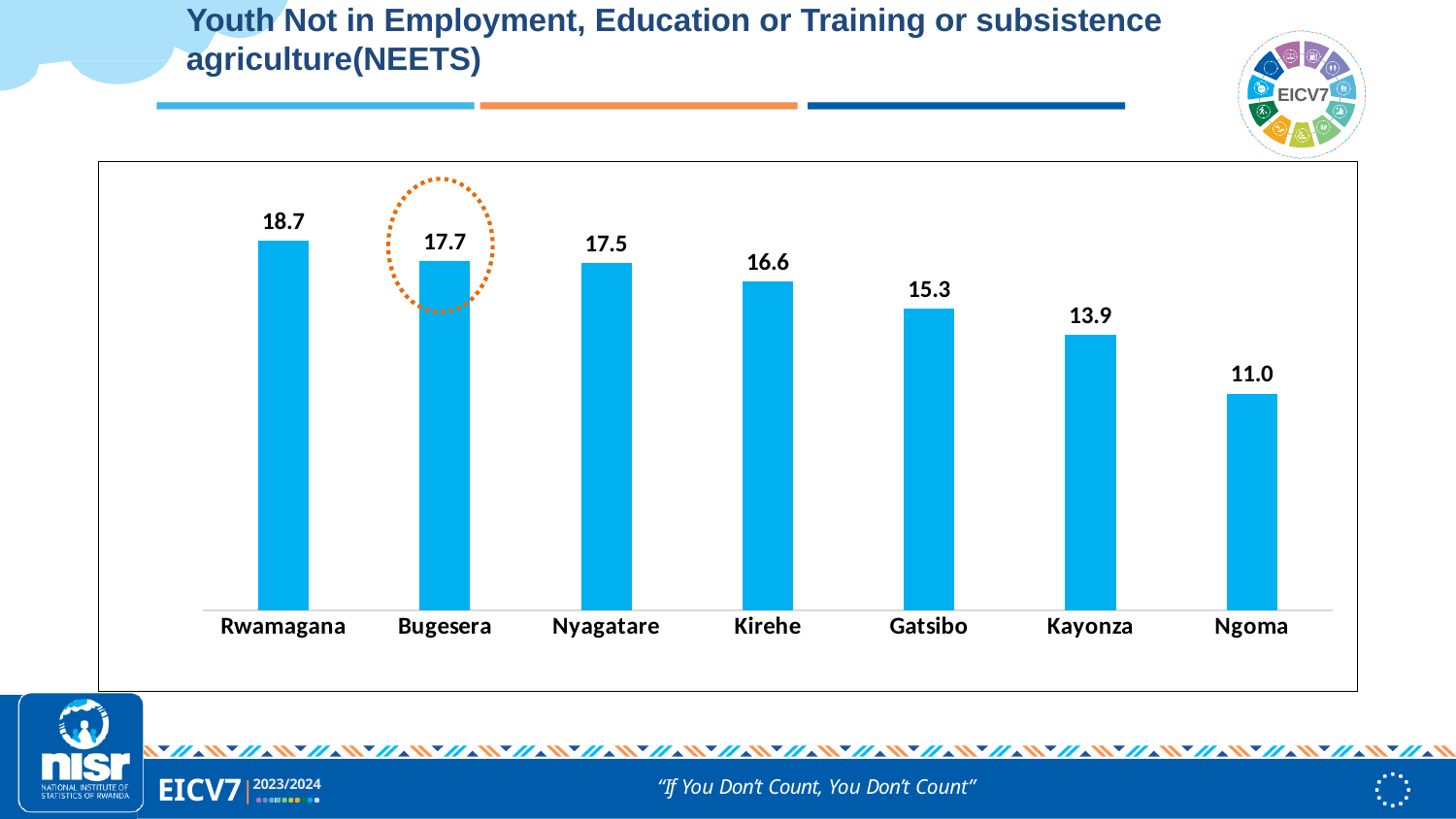
What is the difference between the values for Gatsibo and Kayonza? 1.4 What is the value for Bugesera? 17.7 Which district has the highest value? Rwamagana How many districts are shown in the chart? 7 What kind of chart is shown on the slide? Bar chart What is the value for Rwamagana? 18.7 Which district has the lowest value? Ngoma What is the difference between the values for Rwamagana and Ngoma? 7.7 What is the value for Kirehe? 16.6 What is the value for Ngoma? 11.0 Which district's bar is highlighted with a dotted orange circle? Bugesera Which is larger, the value for Nyagatare or the value for Gatsibo? Nyagatare